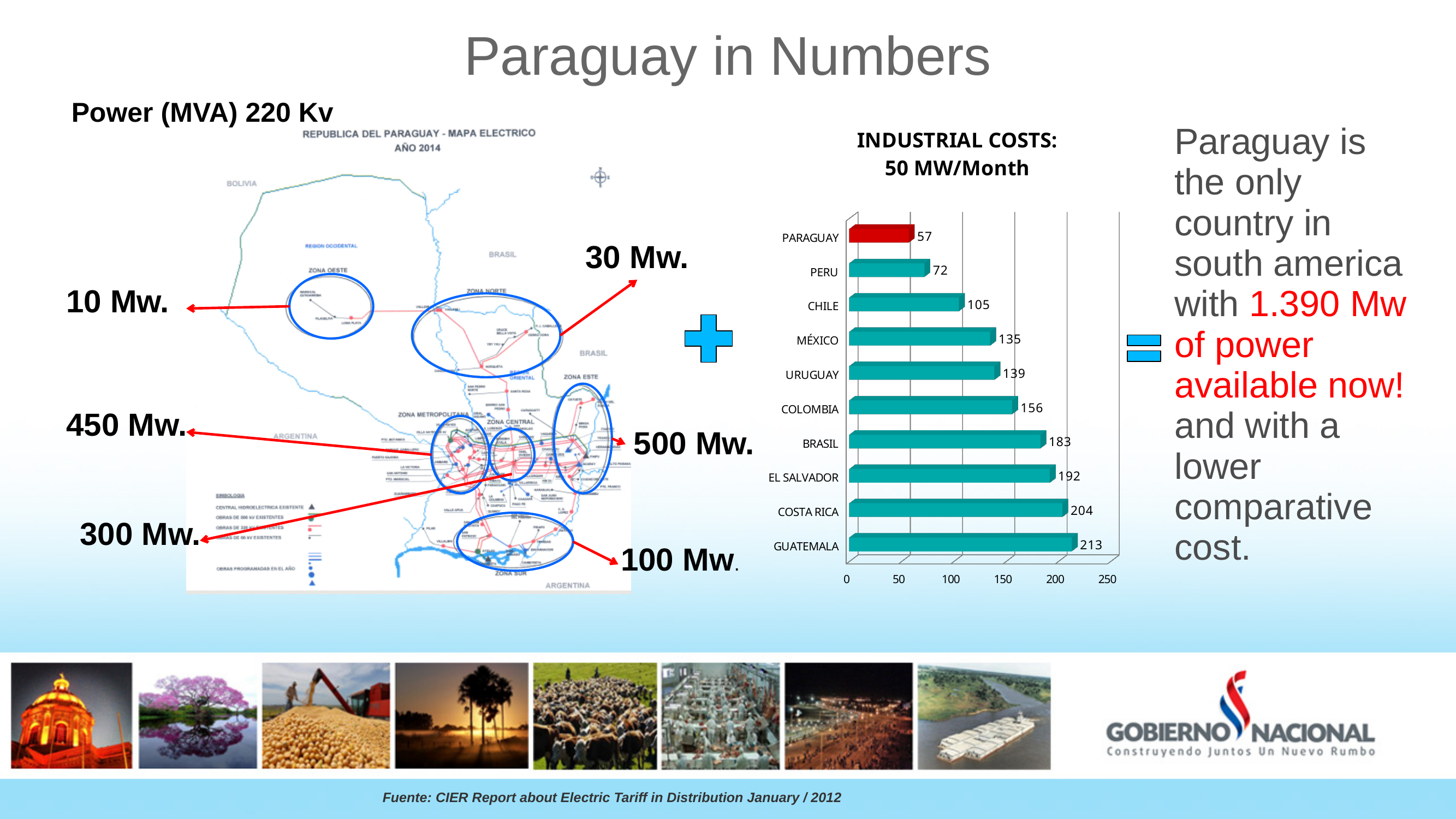
What kind of chart is the Industrial Costs chart? Bar chart What is the value for Paraguay in the Industrial Costs chart? 57 How many countries are shown in the Industrial Costs chart? 10 What is the difference between the values for Guatemala and Paraguay in the Industrial Costs chart? 156 In the Industrial Costs chart, which is larger, the value for Colombia or the value for México? Colombia Which country has the highest value in the Industrial Costs chart? Guatemala Which country has the lowest value in the Industrial Costs chart? Paraguay What is the value for Uruguay in the Industrial Costs chart? 139 What is the title of the bar chart on the slide? INDUSTRIAL COSTS: 50 MW/Month What is the difference between the values for Brasil and Chile in the Industrial Costs chart? 78 In the Industrial Costs chart, is the value for El Salvador greater or less than 150? greater What is the value for Costa Rica in the Industrial Costs chart? 204